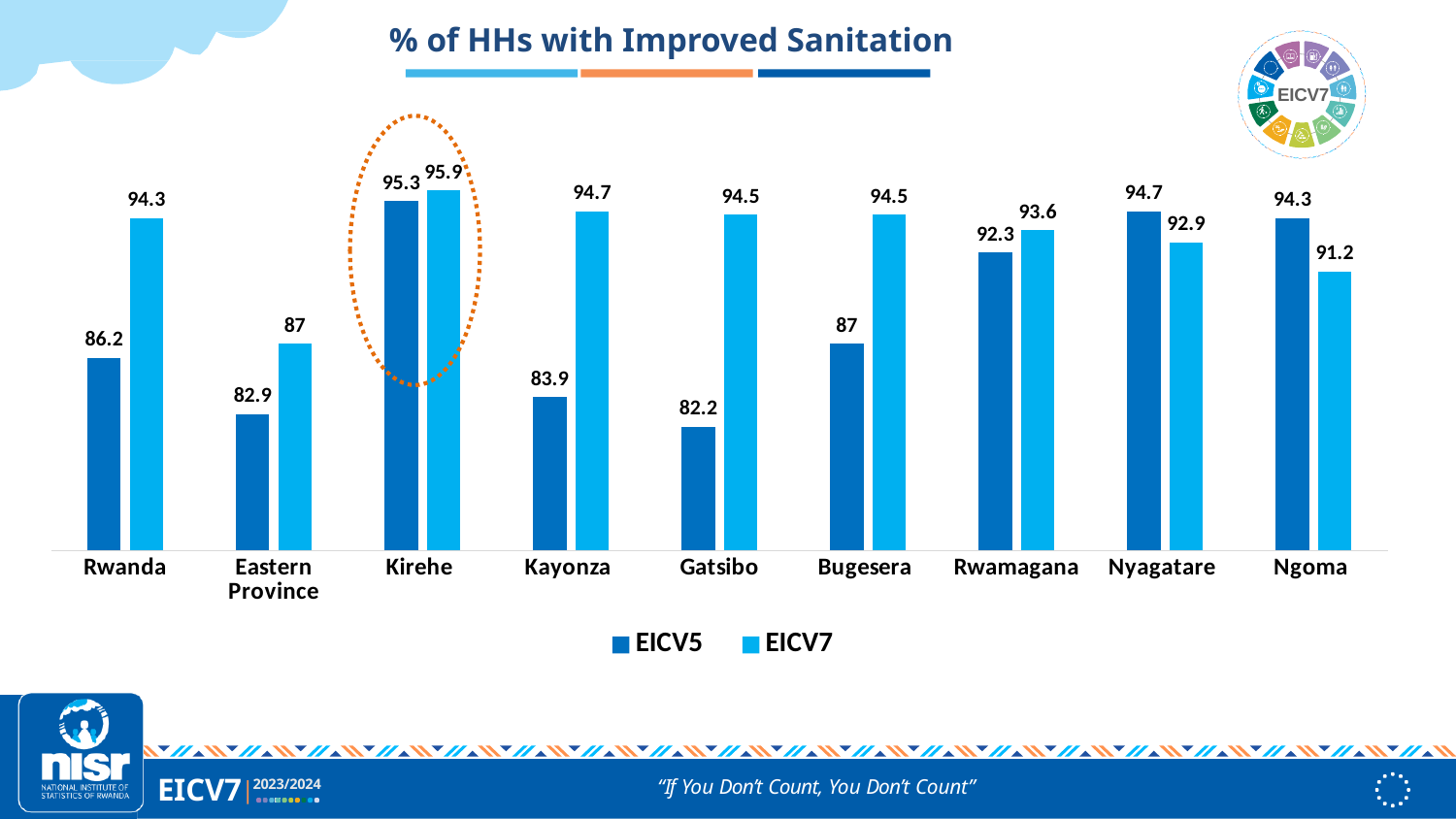
How many categories are shown on the x axis? 9 How many series does the legend list? 2 What is the EICV7 value for Kayonza? 94.7 What is the difference between the EICV7 and EICV5 values for Rwanda? 8.1 What is the EICV5 value for Gatsibo? 82.2 Which category has the lowest EICV5 value? Gatsibo Which category has the highest EICV7 value? Kirehe What is the EICV7 value for Rwamagana? 93.6 For Nyagatare, which is larger: the EICV5 value or the EICV7 value? EICV5 What is the difference between the EICV7 and EICV5 values for Kayonza? 10.8 What kind of chart is shown on the slide? Bar chart Which category is highlighted with a dashed orange circle? Kirehe